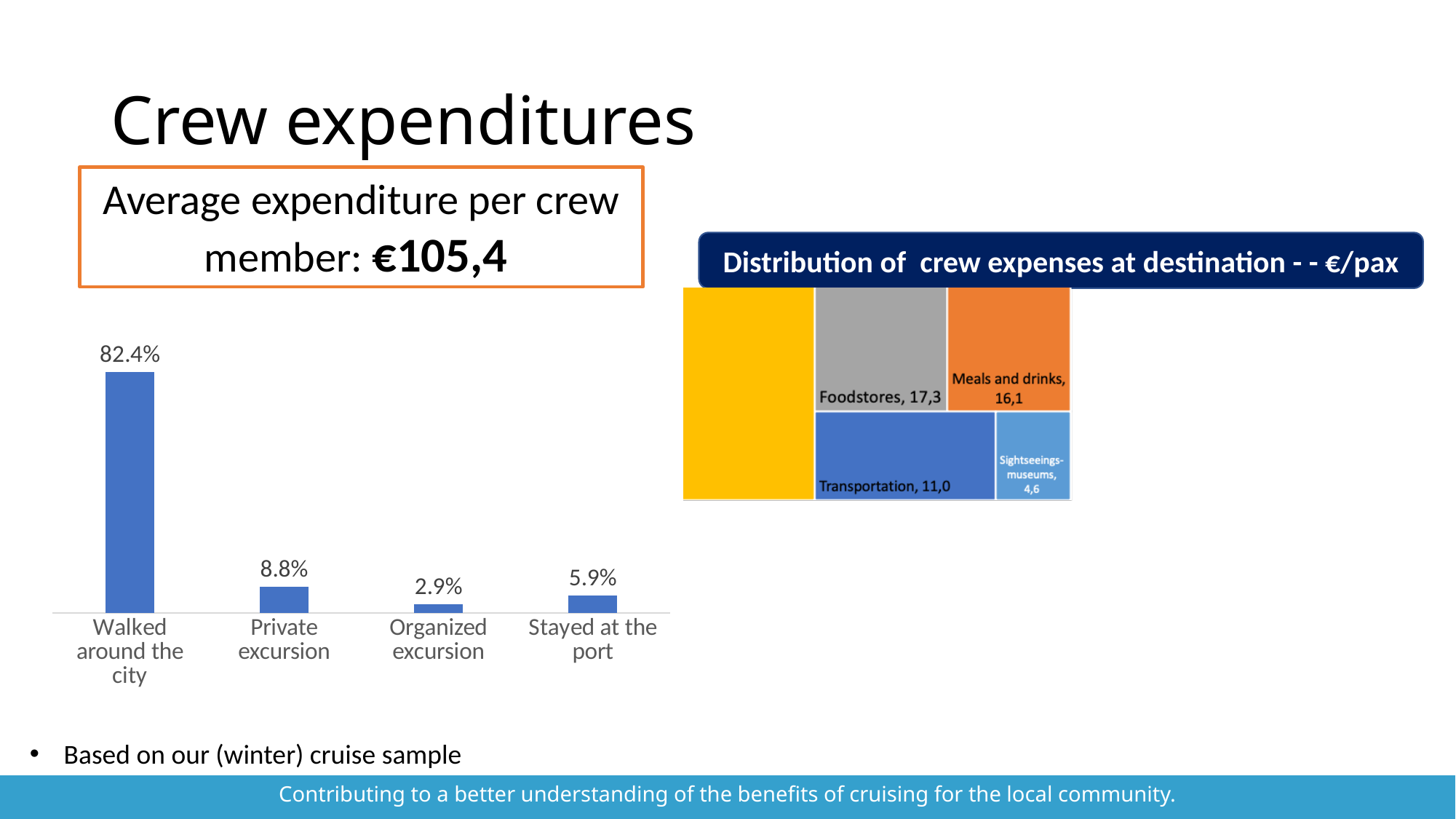
In the bar chart on the left, what is the difference between Private excursion and Organized excursion? 5.9% In the bar chart on the left, what is the value for Private excursion? 8.8% In the bar chart on the left, what is the value for Stayed at the port? 5.9% In the 'Distribution of crew expenses at destination' chart, what is the value for Transportation? 11,0 What kind of chart is the chart on the left of the slide? Bar chart In the bar chart on the left, what percentage of crew members walked around the city? 82.4% In the 'Distribution of crew expenses at destination' chart, what is the value for Foodstores? 17,3 In the 'Distribution of crew expenses at destination' chart, what is the difference between Meals and drinks and Sightseeings-museums? 11,5 In the bar chart on the left, which is larger: Stayed at the port or Private excursion? Private excursion How many categories are shown in the bar chart on the left? 4 In the bar chart on the left, which category has the highest value? Walked around the city In the bar chart on the left, which category has the lowest value? Organized excursion